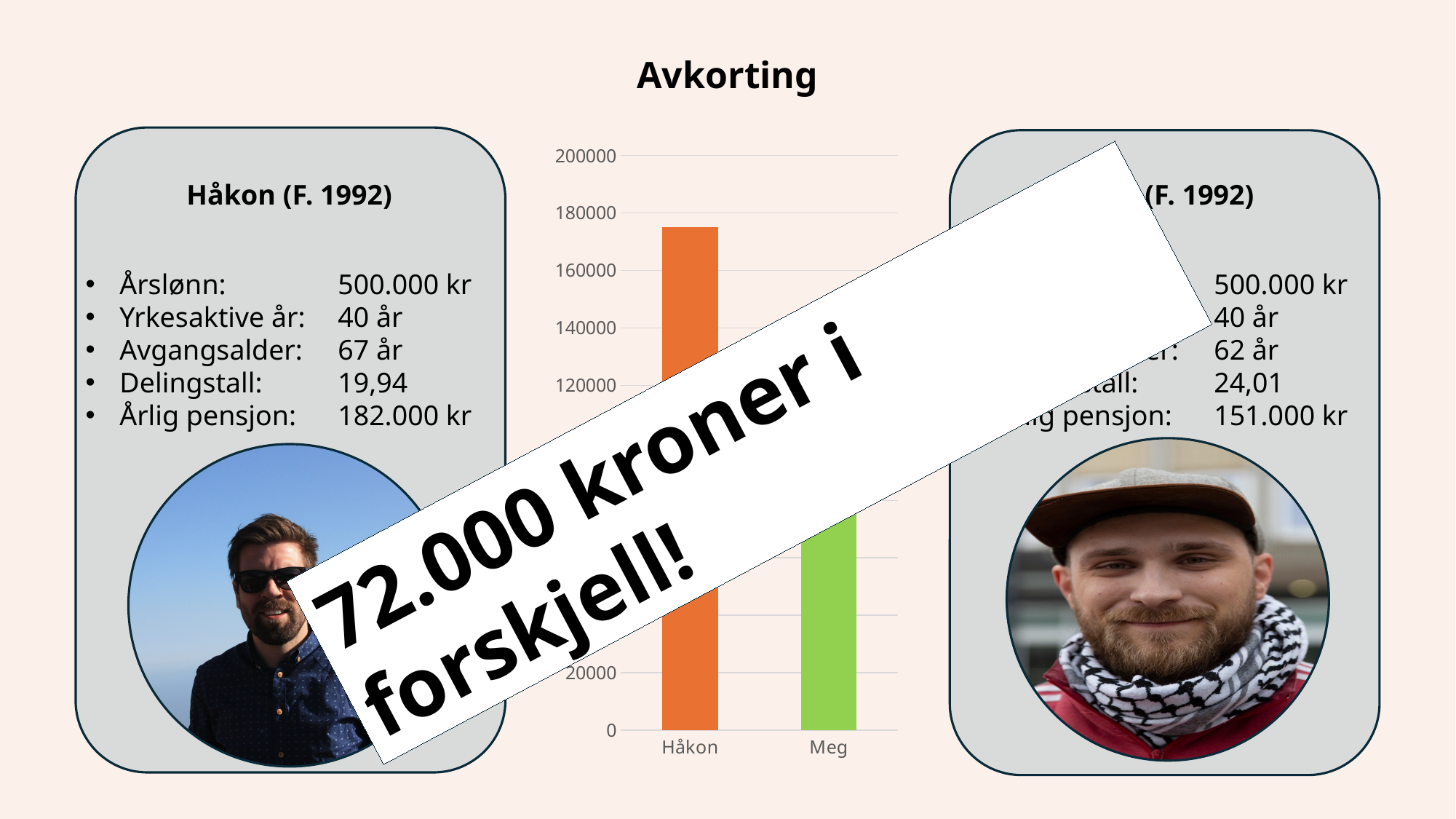
How many bars does the chart have? 2 Which category has the highest bar in the chart? Håkon Which bar is taller, Håkon or Meg? Håkon What colour is the bar for Håkon? orange Is the value for Håkon greater or less than 160000? greater Is the value for Håkon greater or less than 180000? less What is the title of the chart? Avkorting Which category has the lowest bar in the chart? Meg Is the value for Meg greater or less than 60000? greater What is the highest value shown on the vertical axis of the chart? 200000 What kind of chart is shown on the slide? bar chart